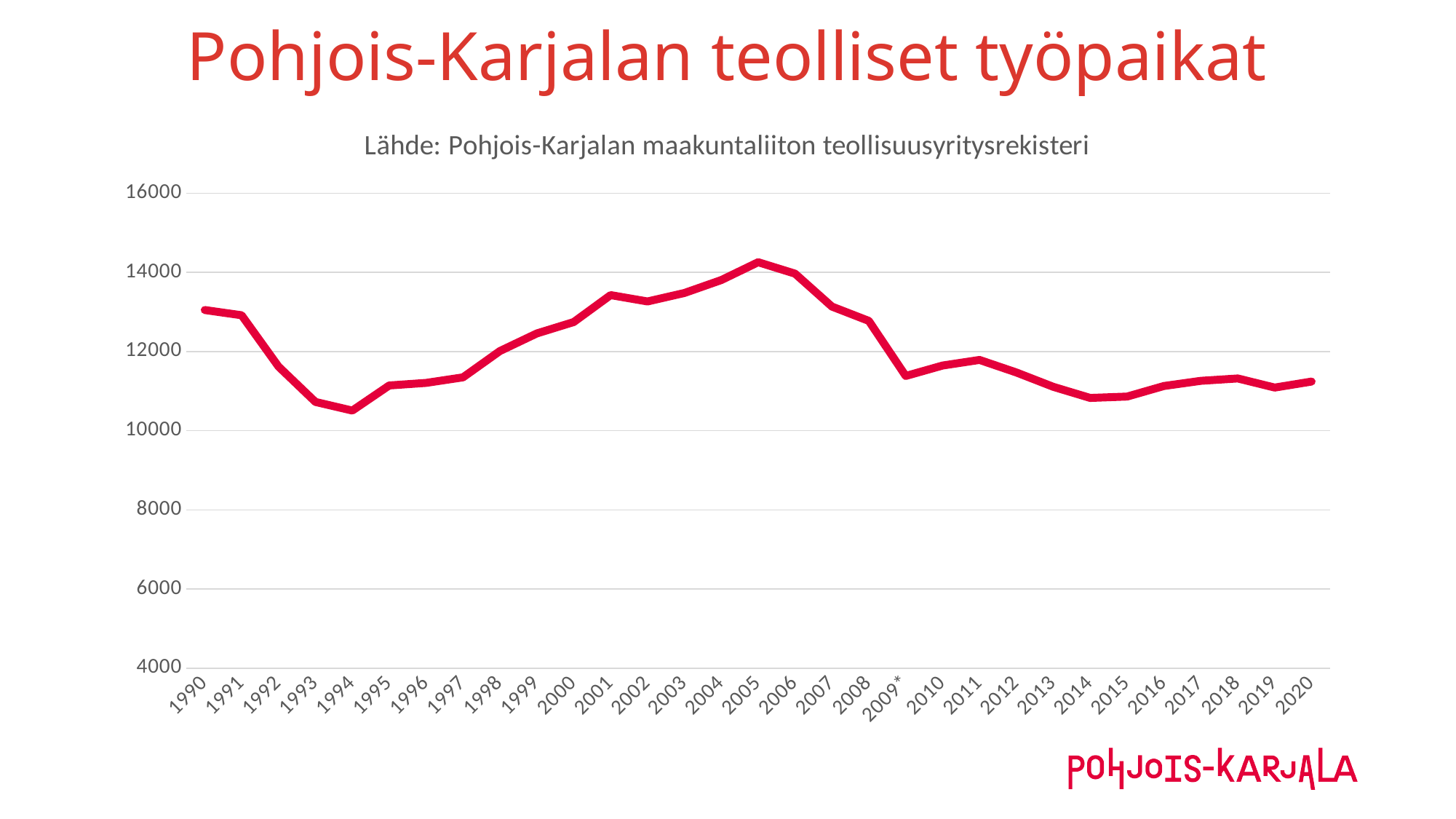
In which year does the line reach its lowest value? 1994 Is the value for 1994 greater or less than 12000? less How many years are plotted along the x axis? 31 Does the line rise or fall between 1994 and 2005? rise What kind of chart is shown on the slide? line chart Is the value for 1990 greater or less than 12000? greater What is the title of the chart? Pohjois-Karjalan teolliset työpaikat Which year has the larger value, 2008 or 2011? 2008 Which year has the larger value, 2005 or 2014? 2005 Is the value for 2014 greater or less than 12000? less In which year does the line reach its highest value? 2005